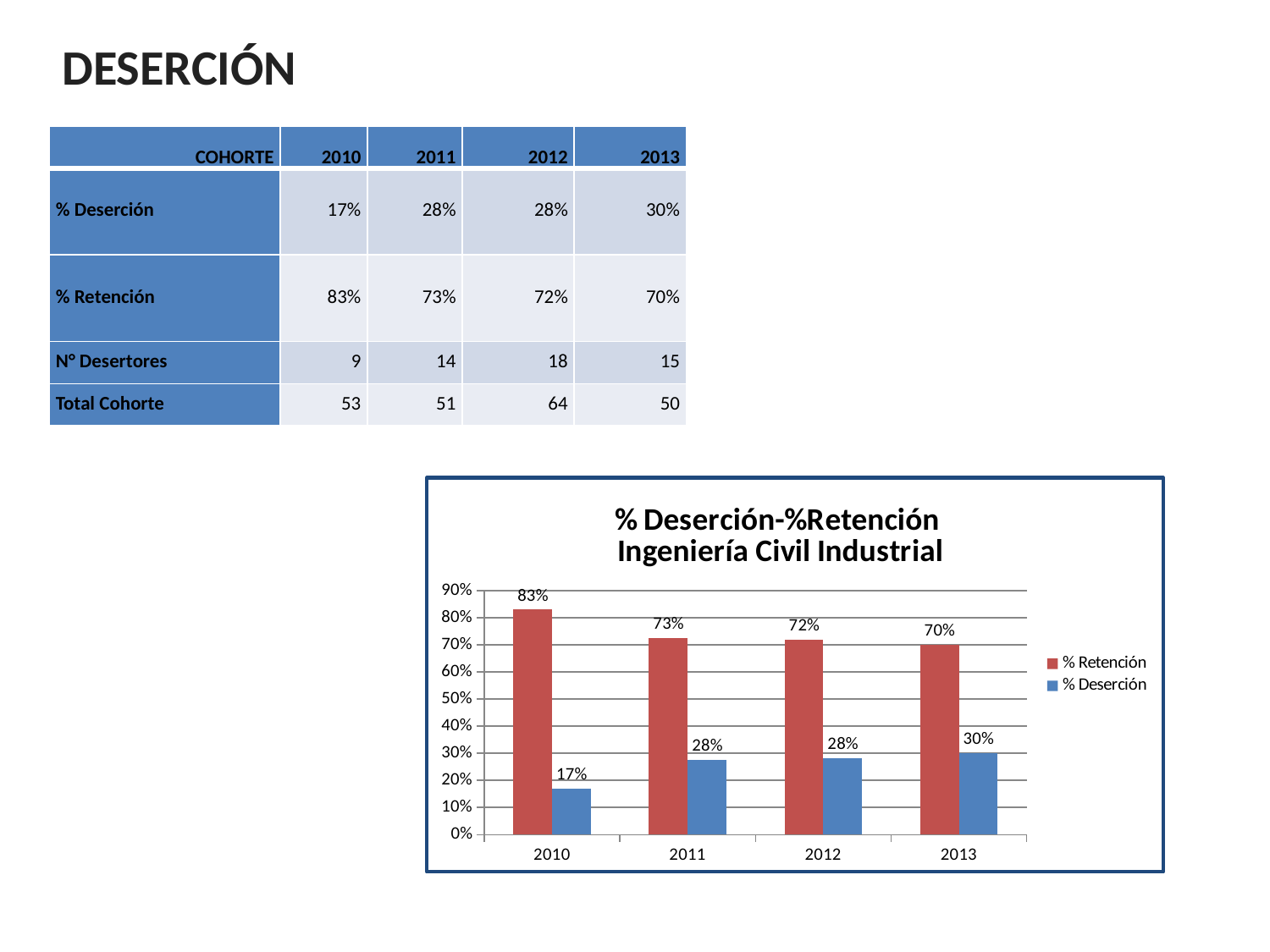
What is the % Retención value for 2010 in the chart? 83% How many years are shown on the x axis of the chart? 4 Which is larger in the chart: % Retención for 2011 or % Retención for 2013? % Retención for 2011 How many series does the chart legend list? 2 What is the % Deserción value for 2013 in the chart? 30% Does % Retención rise or fall from 2010 to 2013 in the chart? Fall What is the % Deserción value for 2011 in the chart? 28% What kind of chart is shown on the slide? Bar chart Which year has the lowest % Deserción in the chart? 2010 What is the title of the chart? % Deserción-%Retención Ingeniería Civil Industrial What is the difference between % Retención and % Deserción for 2013 in the chart? 40% Which year has the highest % Retención in the chart? 2010